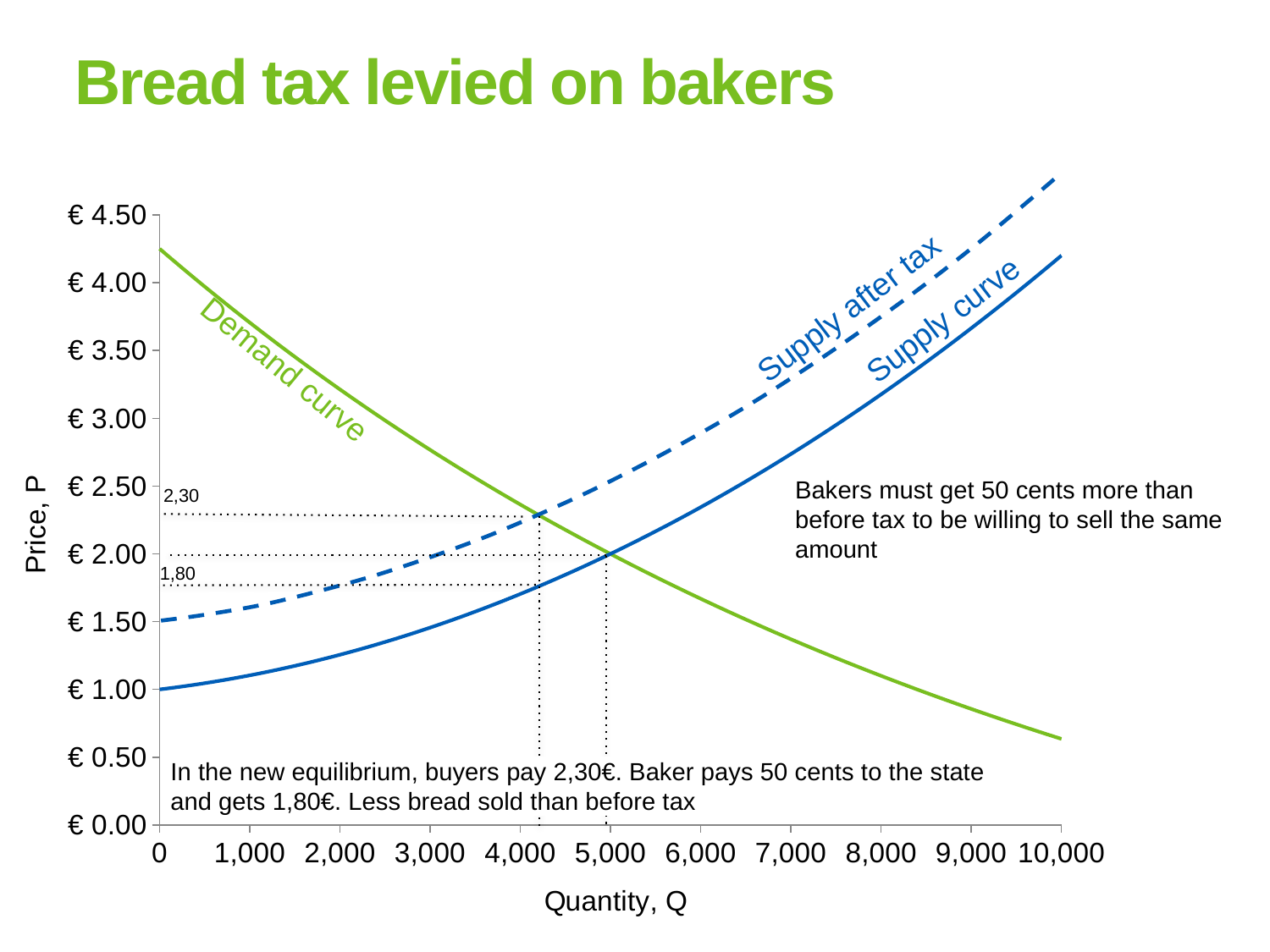
According to the chart, what price do buyers pay in the new equilibrium after the tax? 2,30 Does the supply curve rise or fall as quantity increases? rise According to the chart, what price does the baker get after paying the tax in the new equilibrium? 1,80 Does the demand curve rise or fall as quantity increases? fall Which curve on the chart is drawn as a dashed line? Supply after tax What is the label of the x axis of the chart? Quantity, Q What kind of chart is shown on the slide? line chart Is the value of the demand curve at a quantity of 10,000 greater or less than € 1.00? less How many curves are plotted on the chart? 3 At a quantity of 2,000, which curve is higher: the supply after tax or the supply curve? Supply after tax Is the quantity sold in the new equilibrium after the tax greater or less than 5,000? less What is the difference between the price buyers pay (2,30) and the price the baker gets (1,80) in the new equilibrium? 50 cents